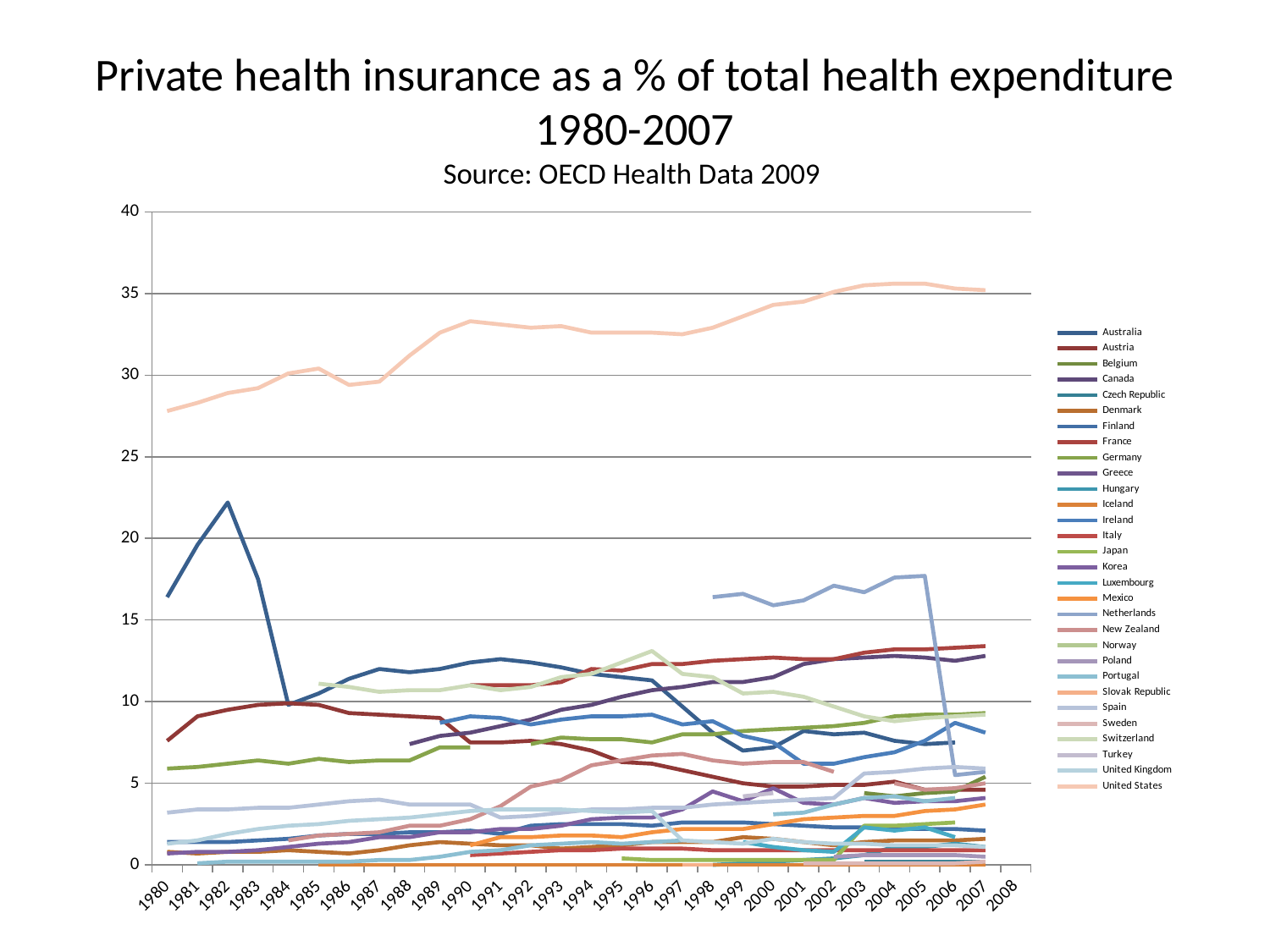
What is the source cited in the chart title? OECD Health Data 2009 Does the United States line generally rise or fall from 1980 to 2007? rise What kind of chart is shown on the slide? line chart Which is larger in 1980, the value for the United States or the value for Australia? United States Is the value for the Netherlands in 2005 greater or less than 15? greater Is the value for the United States in 1980 greater or less than 25? greater Is the value for Australia in 1984 greater or less than 15? less Which country has the highest private health insurance share of total health expenditure across the whole period? United States How many countries does the legend list? 30